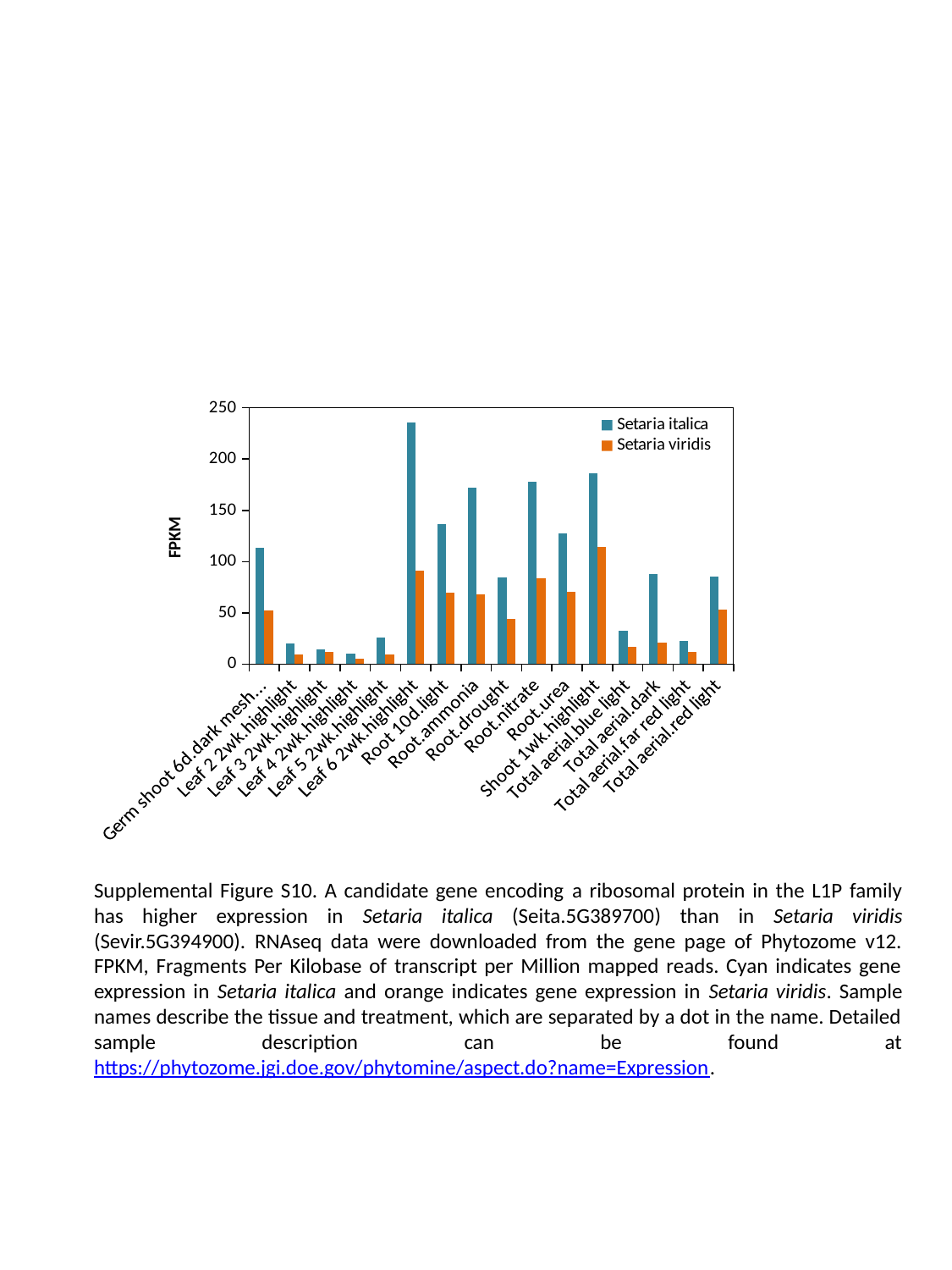
What is the label of the y axis? FPKM What kind of chart is shown on the slide? bar chart Is the Setaria italica value for Leaf 6 2wk.highlight greater or less than 200? greater How many series does the legend list? 2 For which category is the Setaria viridis value highest? Shoot 1wk.highlight Which series is shown in orange? Setaria viridis For which category is the Setaria italica value highest? Leaf 6 2wk.highlight Is the Setaria viridis value for Root.drought greater or less than 50? less Is the Setaria viridis value for Shoot 1wk.highlight greater or less than 100? greater For Root.nitrate, which series has the larger value, Setaria italica or Setaria viridis? Setaria italica How many sample categories are shown on the x axis? 16